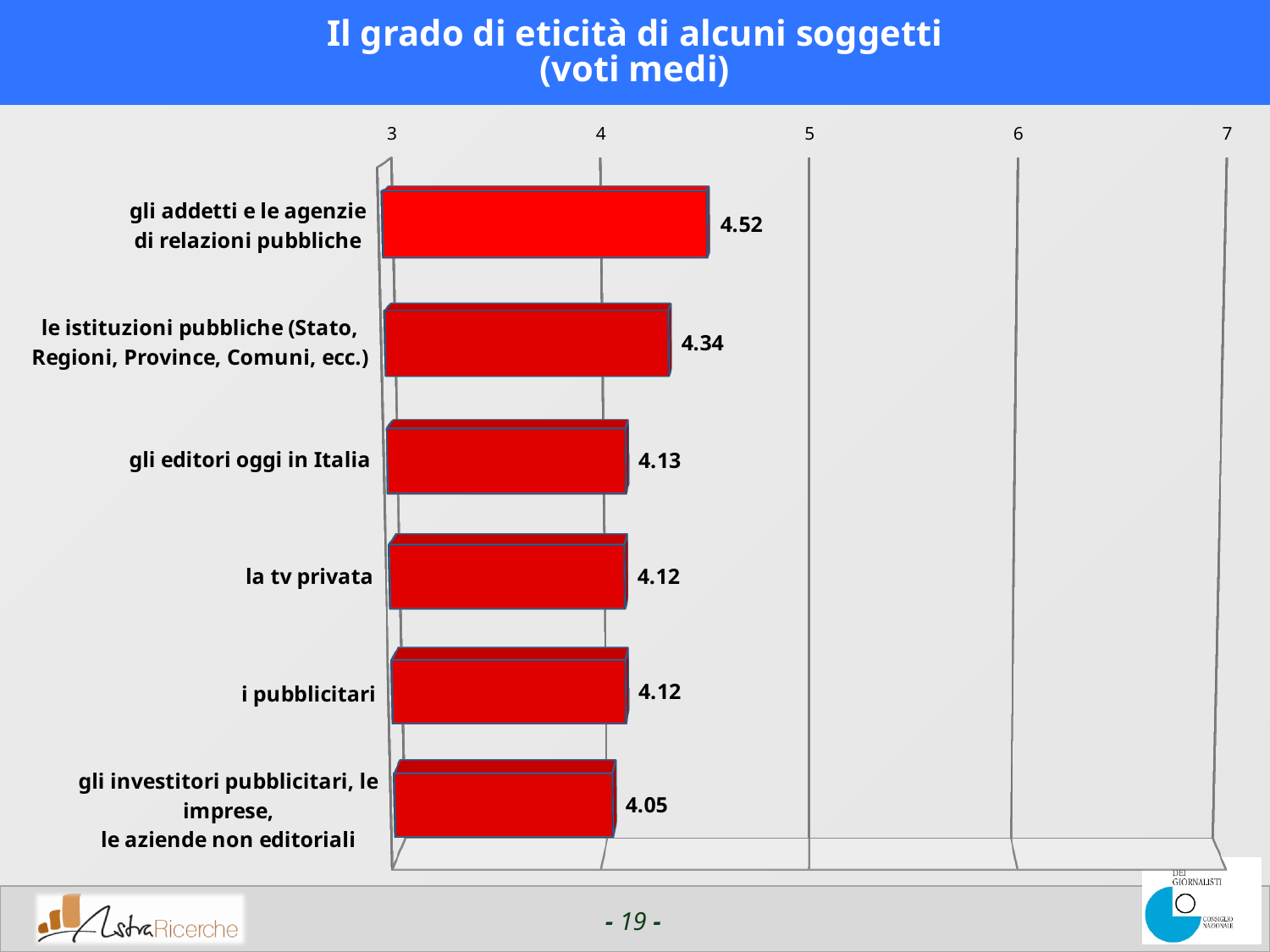
What is the value for "gli investitori pubblicitari, le imprese, le aziende non editoriali"? 4.05 What is the difference between the values for "gli addetti e le agenzie di relazioni pubbliche" and "le istituzioni pubbliche (Stato, Regioni, Province, Comuni, ecc.)"? 0.18 What kind of chart is shown on the slide? bar chart What is the title of the chart? Il grado di eticità di alcuni soggetti (voti medi) Which category has the lowest value? gli investitori pubblicitari, le imprese, le aziende non editoriali Is the value for "la tv privata" greater or less than 5? less What is the value for "gli editori oggi in Italia"? 4.13 How many categories are shown in the chart? 6 What is the value for "gli addetti e le agenzie di relazioni pubbliche"? 4.52 Which category has the highest value? gli addetti e le agenzie di relazioni pubbliche Which is larger: the value for "le istituzioni pubbliche (Stato, Regioni, Province, Comuni, ecc.)" or the value for "gli editori oggi in Italia"? le istituzioni pubbliche (Stato, Regioni, Province, Comuni, ecc.) What is the value for "le istituzioni pubbliche (Stato, Regioni, Province, Comuni, ecc.)"? 4.34